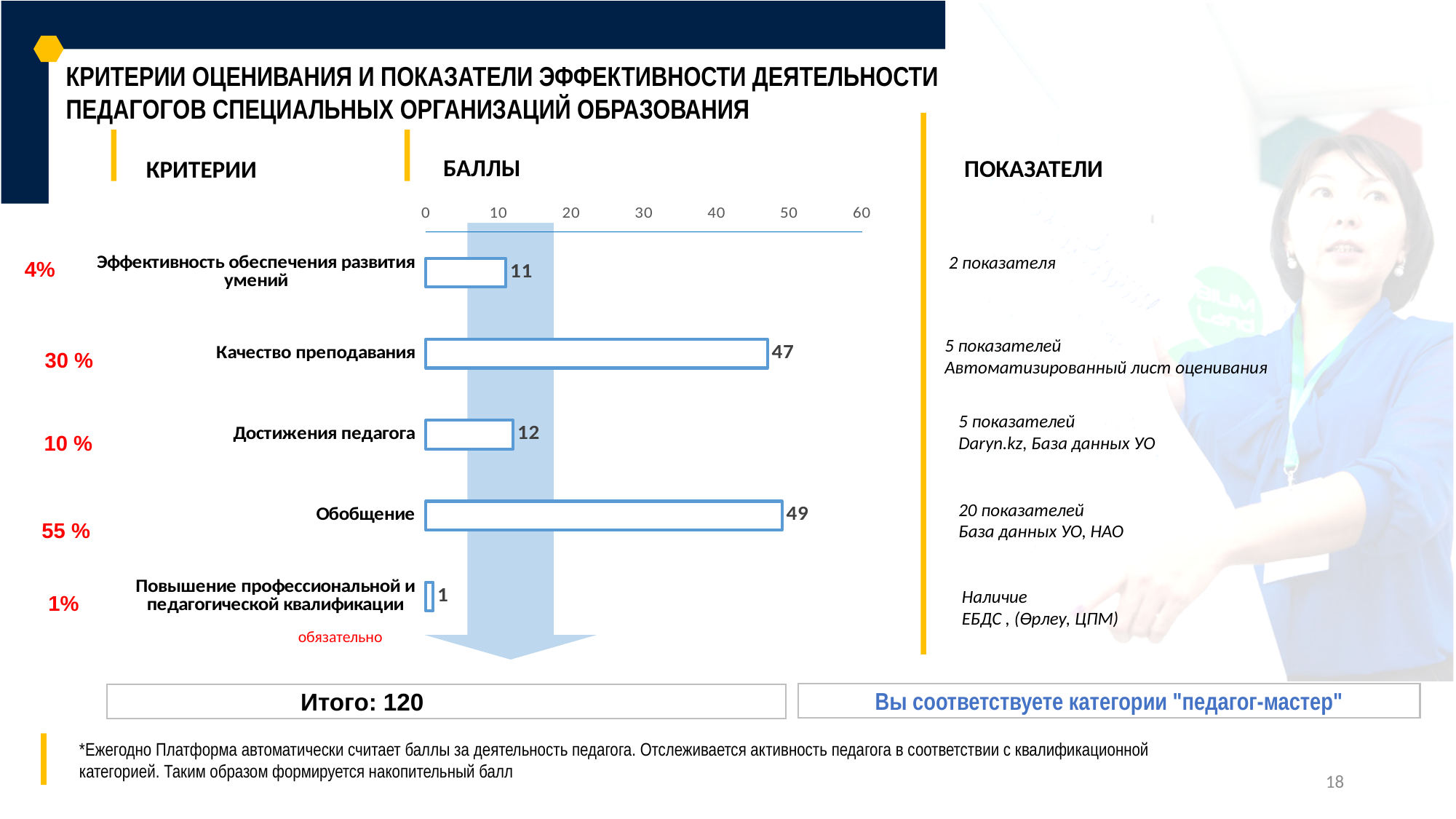
How many categories are plotted in the chart? 5 What value is shown for "Достижения педагога"? 12 What value is shown for "Повышение профессиональной и педагогической квалификации"? 1 What is the maximum value shown on the chart's axis? 60 Is the value for "Качество преподавания" greater or less than 40? greater Which category has the highest value in the chart? Обобщение What value is shown for "Качество преподавания"? 47 What kind of chart is shown on the slide? bar chart Which is larger: the value for "Достижения педагога" or the value for "Эффективность обеспечения развития умений"? Достижения педагога Which category has the lowest value in the chart? Повышение профессиональной и педагогической квалификации What is the difference between the values for "Обобщение" and "Качество преподавания"? 2 What value is shown for "Обобщение"? 49